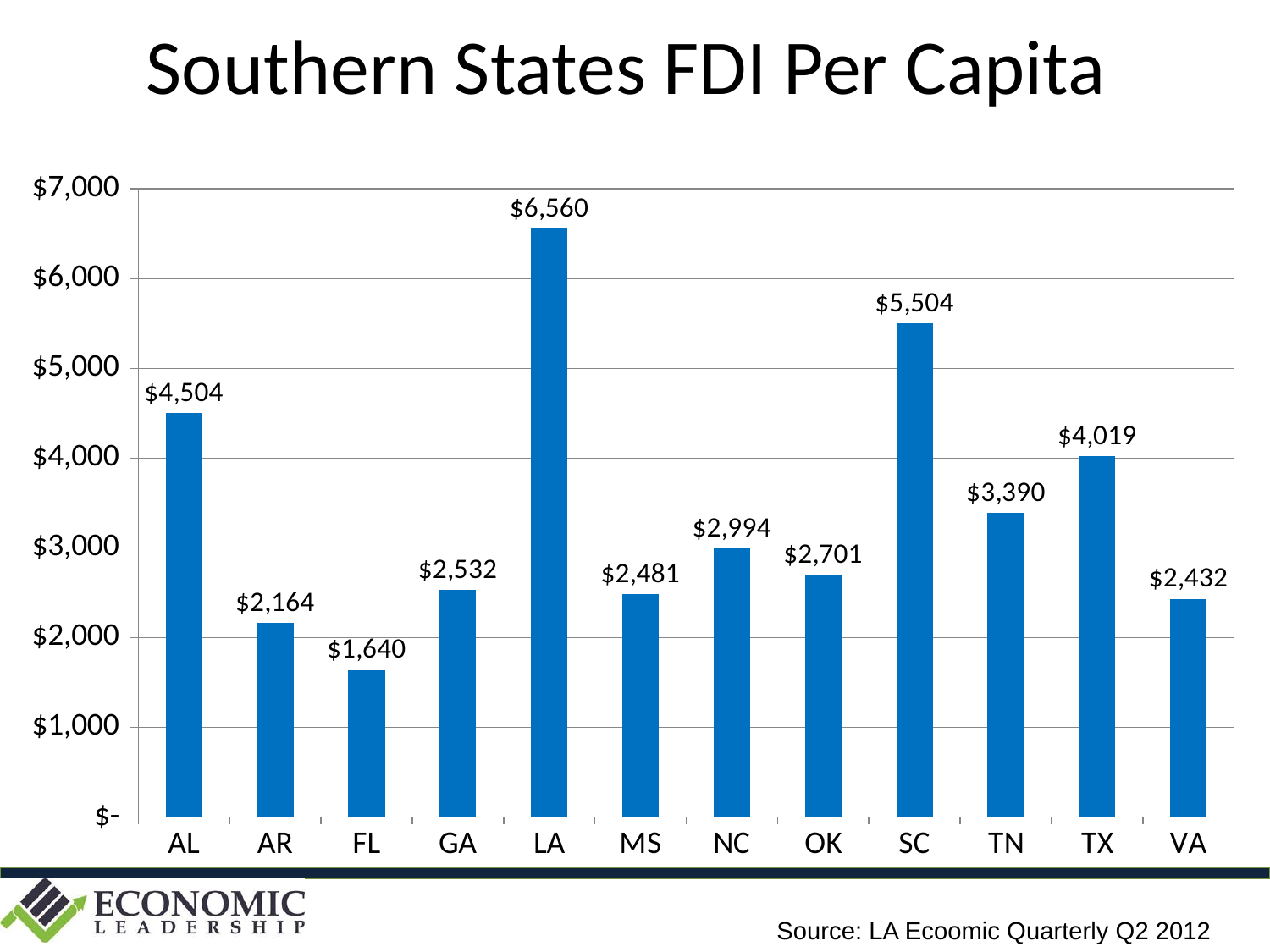
What is the difference between the FDI per capita of AL and TX? $485 What is the FDI per capita value for VA? $2,432 How many states are shown on the chart? 12 What is the difference between the FDI per capita of LA and SC? $1,056 Is the value for GA greater or less than $3,000? less What is the title of the chart? Southern States FDI Per Capita What is the FDI per capita value for TN? $3,390 Which state has the lowest FDI per capita? FL What kind of chart is shown on the slide? bar chart What is the FDI per capita value for LA? $6,560 Which state has the highest FDI per capita? LA Which has a higher FDI per capita, NC or OK? NC